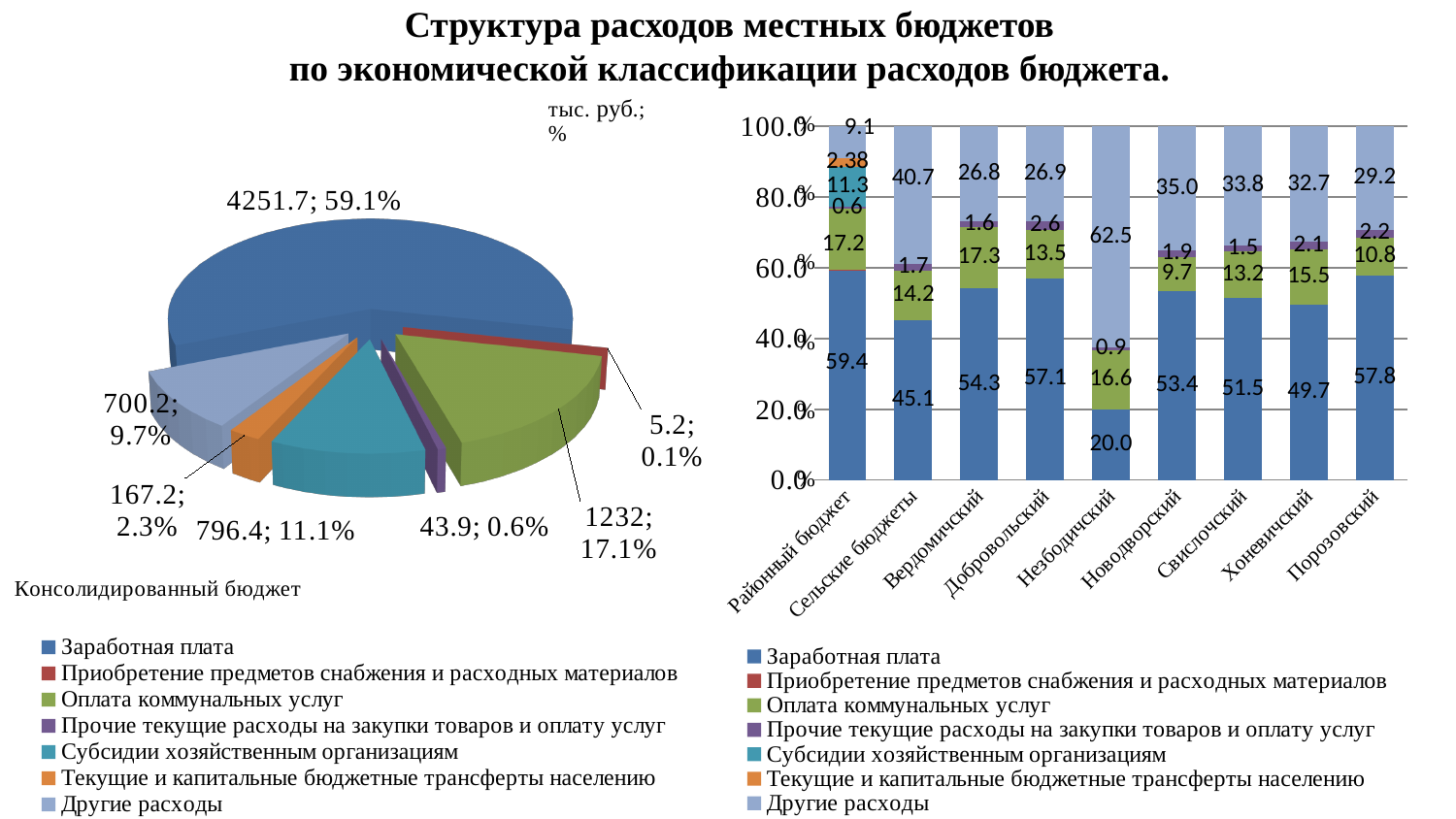
In the stacked bar chart on the right, which is larger: Оплата коммунальных услуг for Вердомичский or for Новодворский? Вердомичский In the pie chart on the left, what share of the pie does Оплата коммунальных услуг take? 17.1% What type of chart is shown on the right side of the slide? Stacked bar chart In the pie chart on the left, what is the value labelled for Субсидии хозяйственным организациям? 796.4; 11.1% In the pie chart on the left, what is the value shown for Заработная плата? 4251.7; 59.1% In the pie chart on the left, how many slices does the pie have? 7 In the stacked bar chart on the right, what is the value of Заработная плата for Незбодичский? 20.0 In the stacked bar chart on the right, which category has the highest value for Другие расходы? Незбодичский In the stacked bar chart on the right, how many series does the legend list? 7 In the stacked bar chart on the right, what is the difference between the Заработная плата values for Районный бюджет and Сельские бюджеты? 14.3 In the stacked bar chart on the right, how many categories are shown on the x axis? 9 In the pie chart on the left, which category has the smallest slice? Приобретение предметов снабжения и расходных материалов